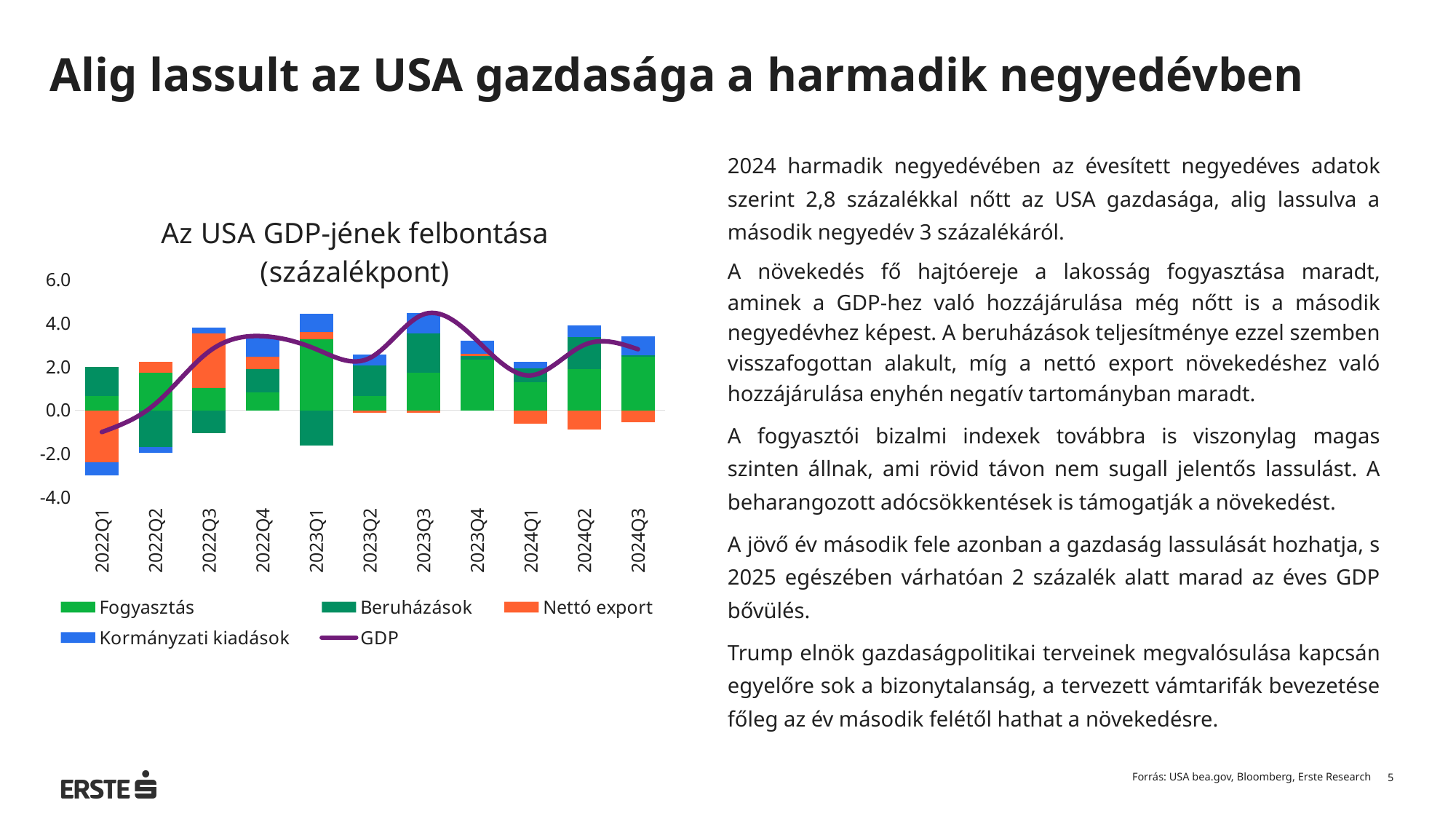
Is the GDP line value for 2024Q1 greater or less than 2.0? less Which quarter has the larger Fogyasztás contribution, 2022Q1 or 2023Q1? 2023Q1 What is the title of the chart? Az USA GDP-jének felbontása (százalékpont) Does the GDP line rise or fall from 2022Q1 to 2022Q4? rise In which quarter does the GDP line reach its lowest value? 2022Q1 Is the GDP line value for 2023Q3 greater or less than 4.0? greater How many quarters are shown on the x axis of the chart? 11 How many series does the chart legend list? 5 In which quarter does the GDP line reach its highest value? 2023Q3 Is the Fogyasztás contribution in 2023Q1 greater or less than 2.0? greater What kind of chart is shown on the slide? stacked bar chart with a line